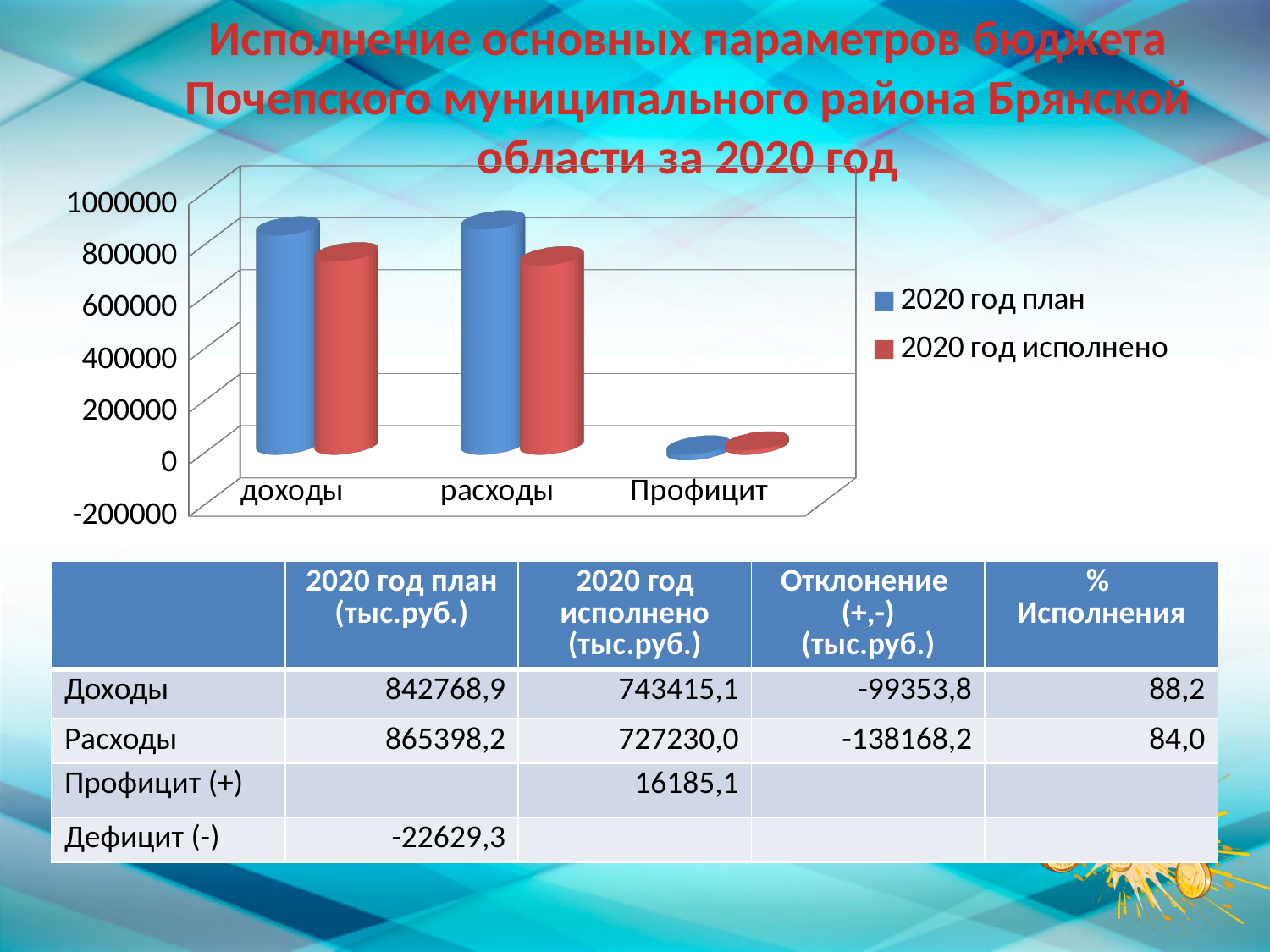
How many categories are shown on the x axis of the chart? 3 Is the 2020 год план value for расходы greater or less than 800000? greater What kind of chart is shown on the slide? bar chart What is the difference between the 2020 год план and 2020 год исполнено values for доходы? 99353,8 For доходы, which is larger: 2020 год план or 2020 год исполнено? 2020 год план Do the 2020 год исполнено values rise or fall from доходы to Профицит along the x axis? fall How many series does the chart legend list? 2 What are the two series named in the chart legend? 2020 год план and 2020 год исполнено What is the 2020 год исполнено value for расходы? 727230,0 What is the 2020 год план value for доходы? 842768,9 Is the 2020 год исполнено value for доходы greater or less than 800000? less Which category has the lowest 2020 год исполнено value? Профицит